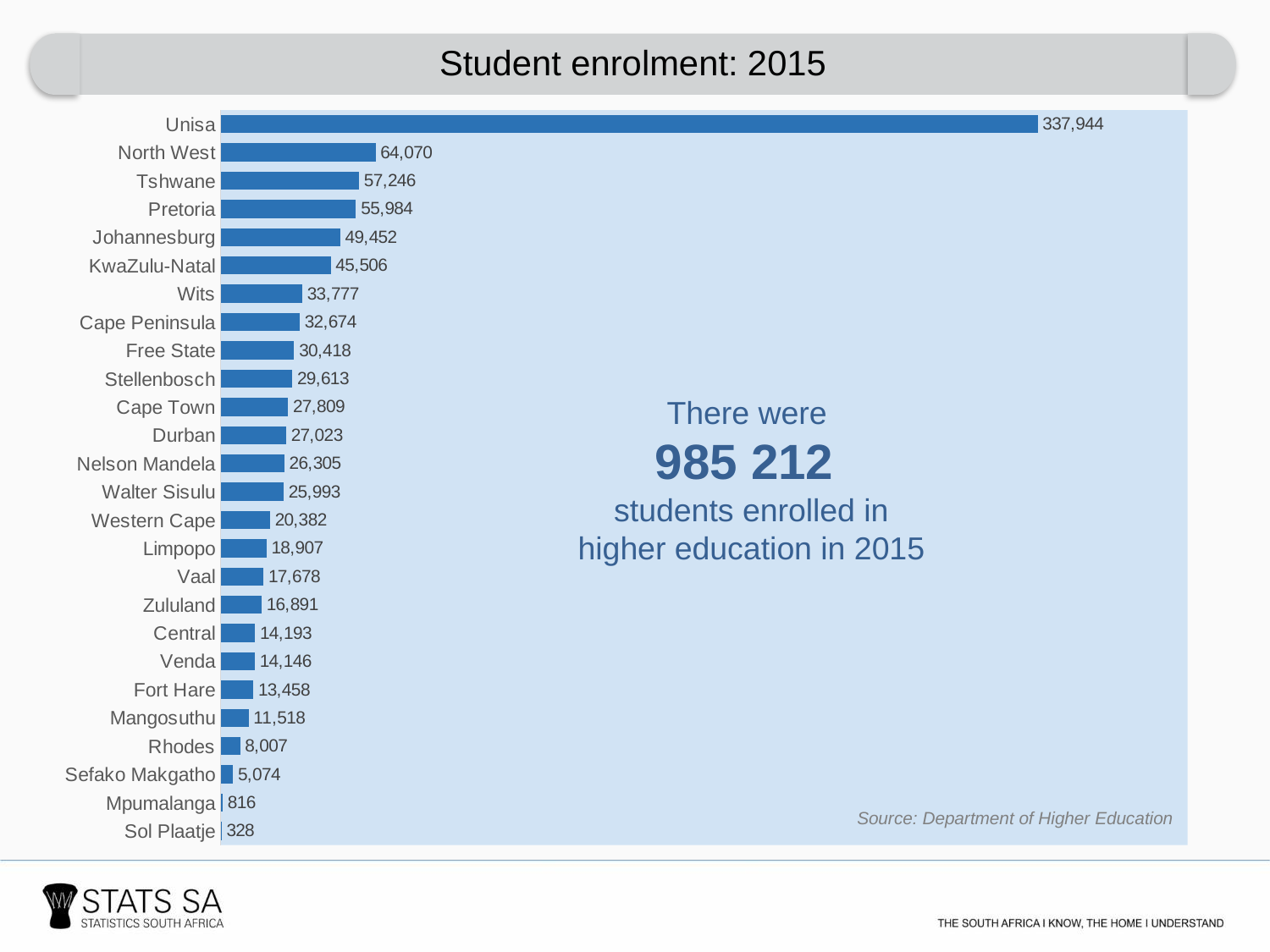
Which has a larger enrolment, Johannesburg or KwaZulu-Natal? Johannesburg What is the student enrolment for Unisa? 337,944 How many institutions are shown in the chart? 26 What is the difference in enrolment between Rhodes and Sefako Makgatho? 2,933 Which institution has the lowest student enrolment? Sol Plaatje What is the student enrolment for Stellenbosch? 29,613 What is the difference in enrolment between Unisa and North West? 273,874 What is the student enrolment for Fort Hare? 13,458 What kind of chart is shown on the slide? Bar chart According to the text on the chart, how many students were enrolled in higher education in 2015 in total? 985 212 What is the student enrolment for Sol Plaatje? 328 Which institution has the highest student enrolment? Unisa